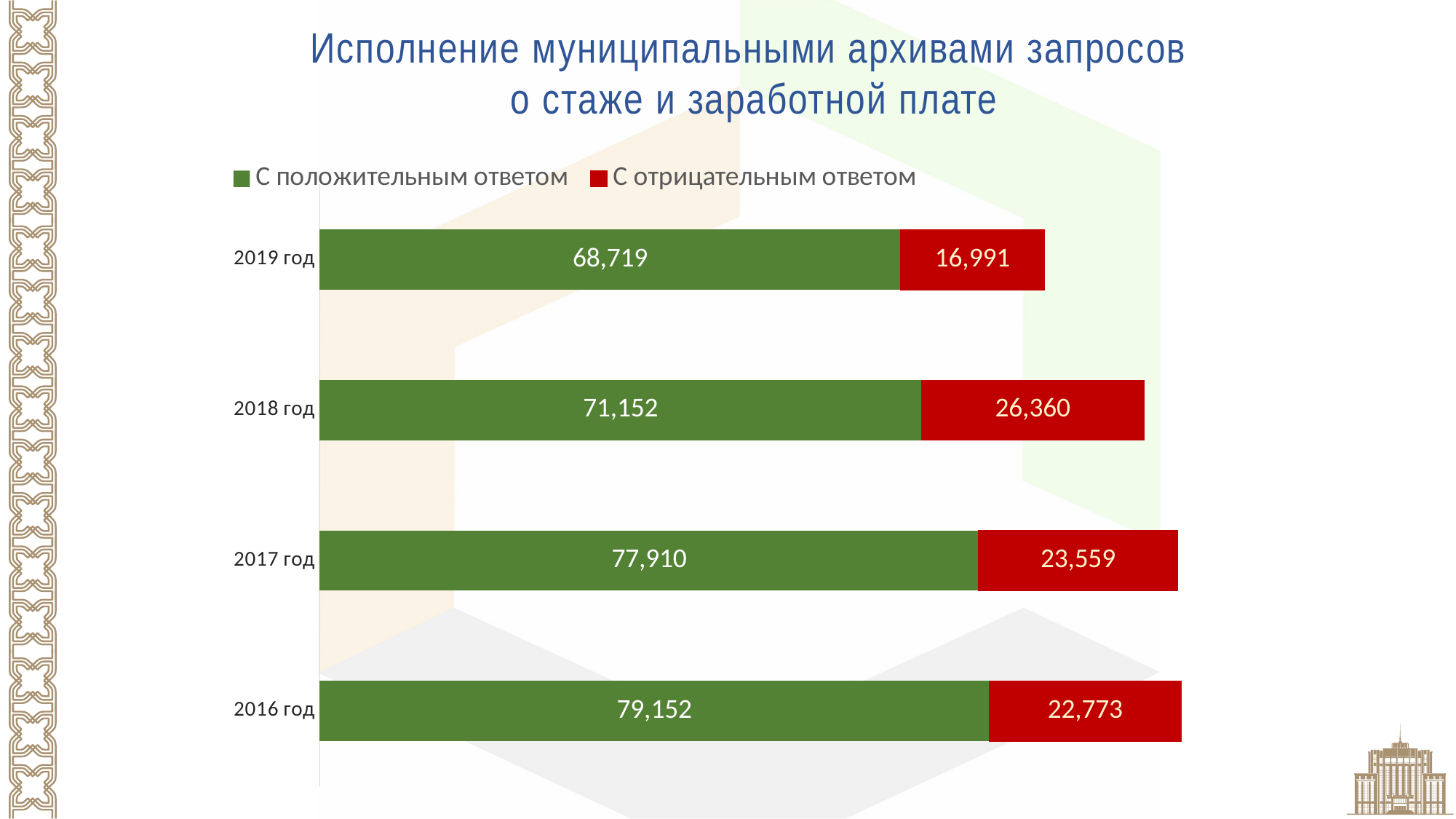
Which is larger: 'С отрицательным ответом' in 2017 год or in 2016 год? 2017 год What is the total of the stacked bar for 2018 год? 97,512 Do the 'С положительным ответом' values rise or fall from 2016 год to 2019 год? Fall What is the value for 'С отрицательным ответом' in 2018 год? 26,360 How many years are shown on the chart? 4 Which year has the highest value for 'С положительным ответом'? 2016 год How many series does the legend list? 2 Which year has the lowest value for 'С отрицательным ответом'? 2019 год What is the difference between the 'С положительным ответом' values for 2016 год and 2019 год? 10,433 What kind of chart is shown on the slide? Stacked bar chart What is the value for 'С положительным ответом' in 2016 год? 79,152 What is the value for 'С положительным ответом' in 2019 год? 68,719